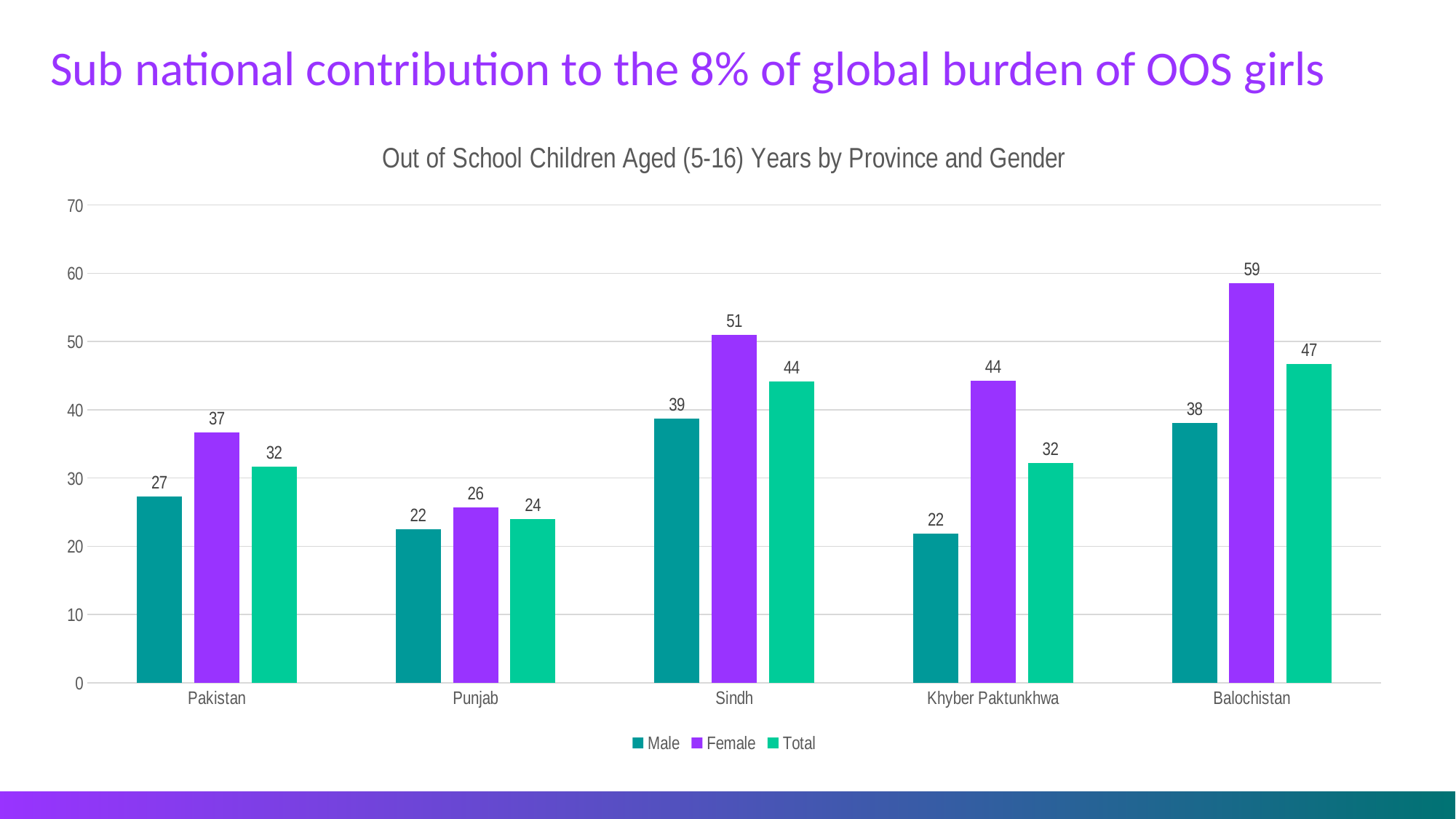
What is the title of the chart? Out of School Children Aged (5-16) Years by Province and Gender How many series does the legend list? 3 What kind of chart is shown on the slide? Bar chart How many provinces/categories are shown on the x axis? 5 What is the difference between the Female and Male values for Khyber Paktunkhwa? 22 Which is larger, the Total value for Sindh or the Total value for Balochistan? Balochistan Which province has the lowest Total value? Punjab What is the Female value for Balochistan? 59 What is the Total value for Punjab? 24 Is the Female value for Sindh greater or less than 50? greater Which province has the highest Female value? Balochistan What is the Male value for Sindh? 39